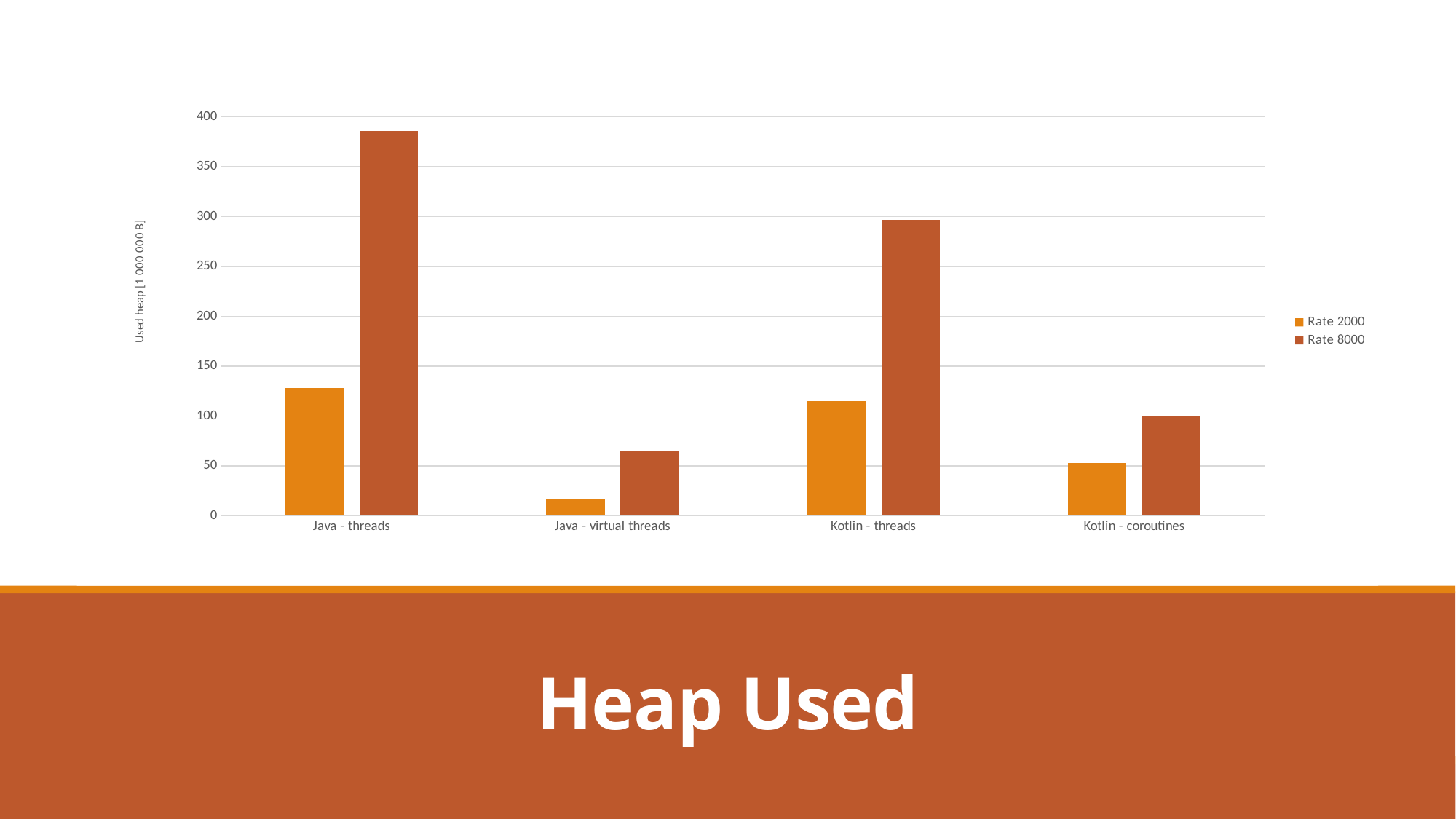
Which category has the lowest Rate 2000 value? Java - virtual threads How many series does the chart's legend list? 2 Which category has the lowest Rate 8000 value? Java - virtual threads Which is larger, the Rate 2000 value for Java - threads or the Rate 2000 value for Kotlin - coroutines? Java - threads What is the label of the vertical axis of the chart? Used heap [1 000 000 B] Is the Rate 2000 value for Java - virtual threads greater or less than 50? less Which category has the highest Rate 8000 value? Java - threads How many categories are shown on the x axis of the chart? 4 What kind of chart is shown on the slide? bar chart Is the Rate 8000 value for Java - threads greater or less than 350? greater Is the Rate 8000 value for Kotlin - threads greater or less than 250? greater Which is larger, the Rate 8000 value for Kotlin - threads or the Rate 8000 value for Kotlin - coroutines? Kotlin - threads